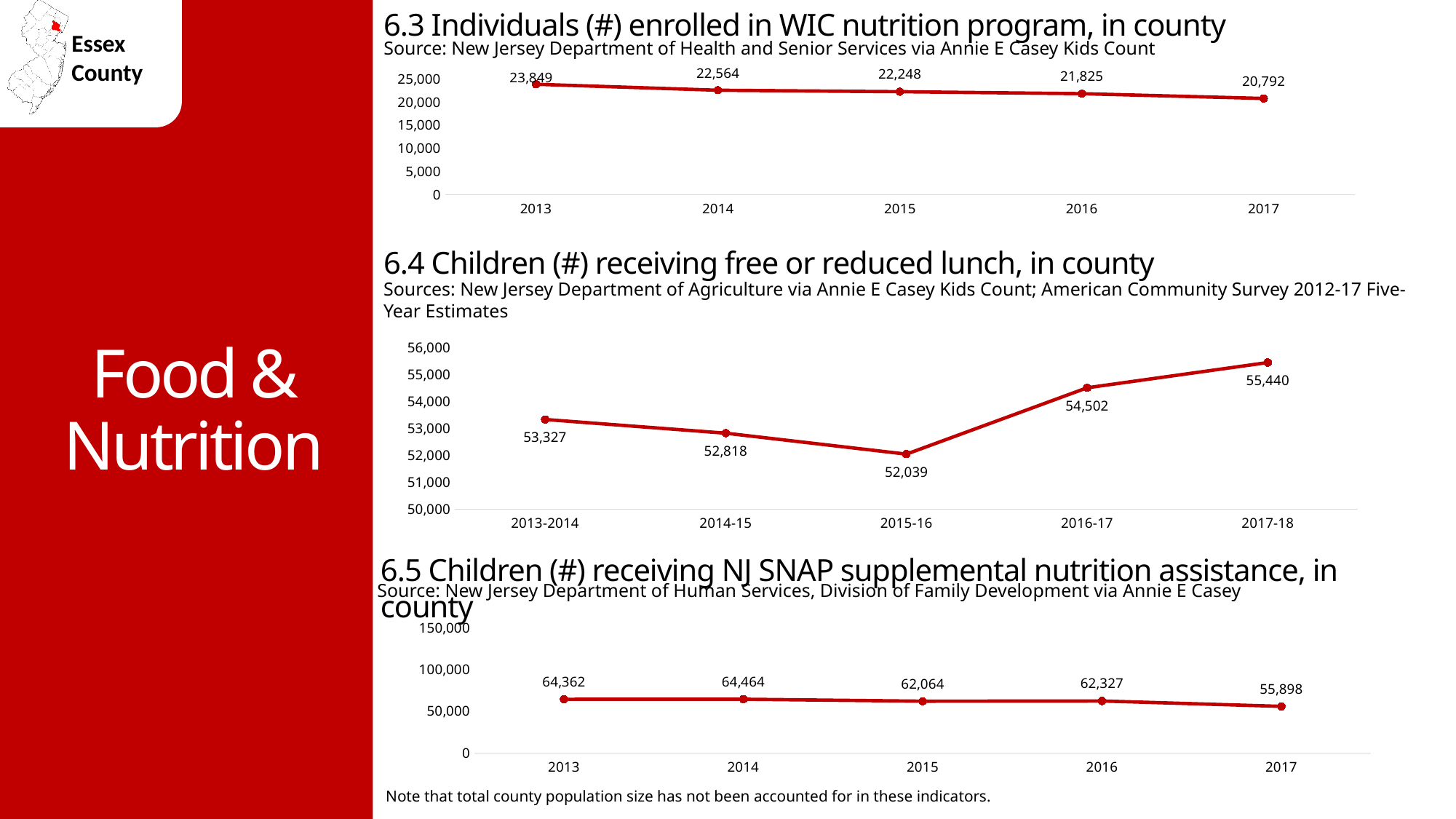
In the chart '6.5 Children (#) receiving NJ SNAP supplemental nutrition assistance, in county', what is the value for 2017? 55,898 In the chart '6.3 Individuals (#) enrolled in WIC nutrition program, in county', which year has the lowest value? 2017 In the chart '6.4 Children (#) receiving free or reduced lunch, in county', which period has the highest value? 2017-18 In the chart '6.3 Individuals (#) enrolled in WIC nutrition program, in county', what is the value for 2013? 23,849 In the chart '6.4 Children (#) receiving free or reduced lunch, in county', what is the difference between the 2017-18 and 2016-17 values? 938 In the chart '6.5 Children (#) receiving NJ SNAP supplemental nutrition assistance, in county', is the value for 2014 greater or less than 50,000? greater In the chart '6.5 Children (#) receiving NJ SNAP supplemental nutrition assistance, in county', which is larger, the value for 2015 or the value for 2016? 2016 What type of chart is '6.5 Children (#) receiving NJ SNAP supplemental nutrition assistance, in county'? line chart In the chart '6.4 Children (#) receiving free or reduced lunch, in county', how many data points are plotted? 5 In the chart '6.3 Individuals (#) enrolled in WIC nutrition program, in county', what is the difference between the 2013 and 2017 values? 3,057 In the chart '6.4 Children (#) receiving free or reduced lunch, in county', what is the value for 2015-16? 52,039 In the chart '6.3 Individuals (#) enrolled in WIC nutrition program, in county', do the values rise or fall from 2013 to 2017? fall